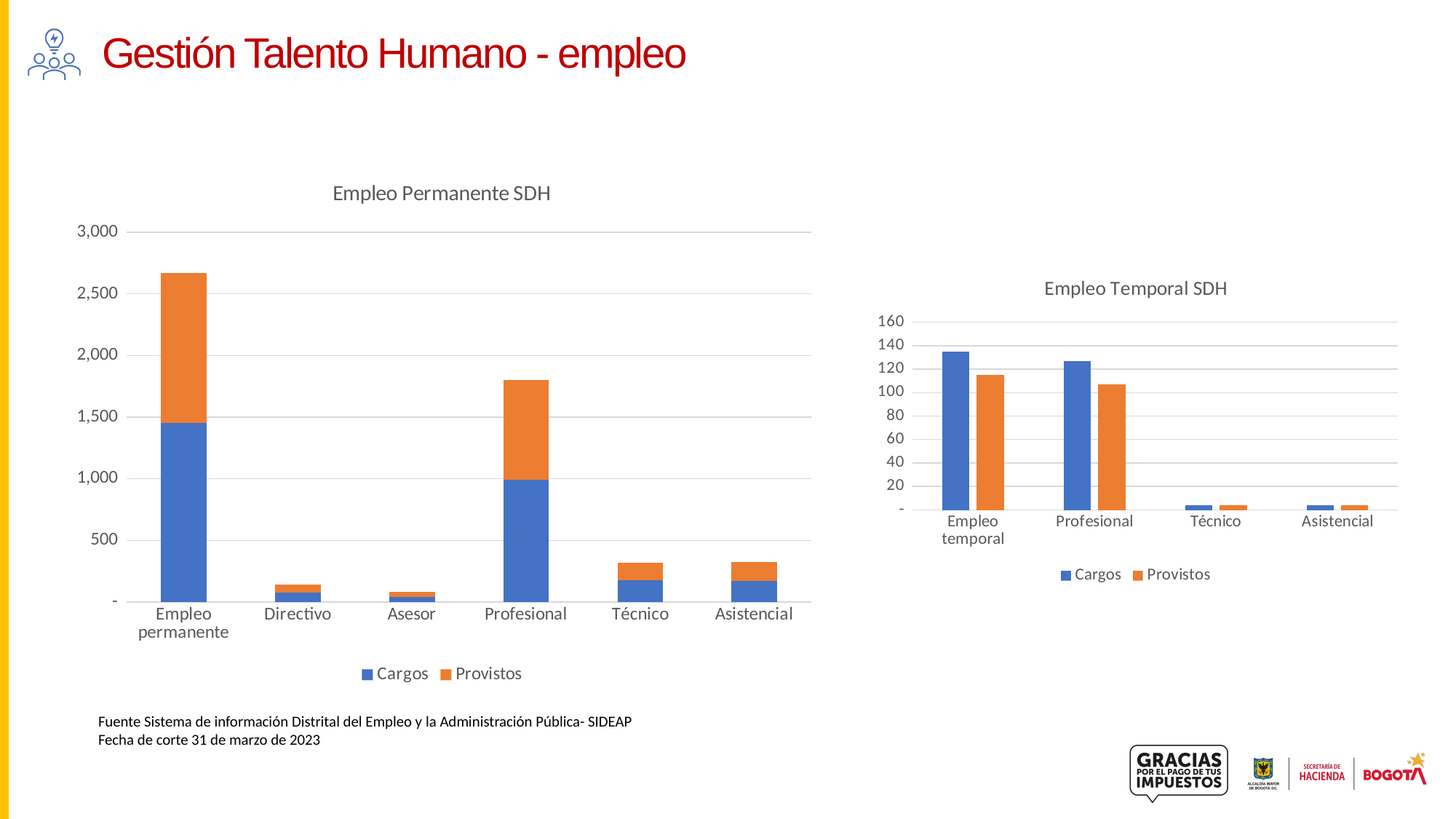
In the 'Empleo Temporal SDH' chart, how many categories are shown on the x axis? 4 In the 'Empleo Temporal SDH' chart, is the Cargos value for Empleo temporal greater or less than 120? greater In the 'Empleo Permanente SDH' chart, which category has the tallest stacked bar? Empleo permanente In the 'Empleo Permanente SDH' chart, which category has the shortest stacked bar? Asesor In the 'Empleo Permanente SDH' chart, what kind of chart is shown? Bar chart In the 'Empleo Permanente SDH' chart, how many series does the legend list? 2 In the 'Empleo Permanente SDH' chart, is the Cargos value for Profesional greater or less than 500? greater In the 'Empleo Temporal SDH' chart, for Profesional, which is larger: Cargos or Provistos? Cargos In the 'Empleo Permanente SDH' chart, how many categories are shown on the x axis? 6 In the 'Empleo Permanente SDH' chart, is the Cargos value for Empleo permanente greater or less than 1,000? greater In the 'Empleo Temporal SDH' chart, what are the two legend entries? Cargos and Provistos